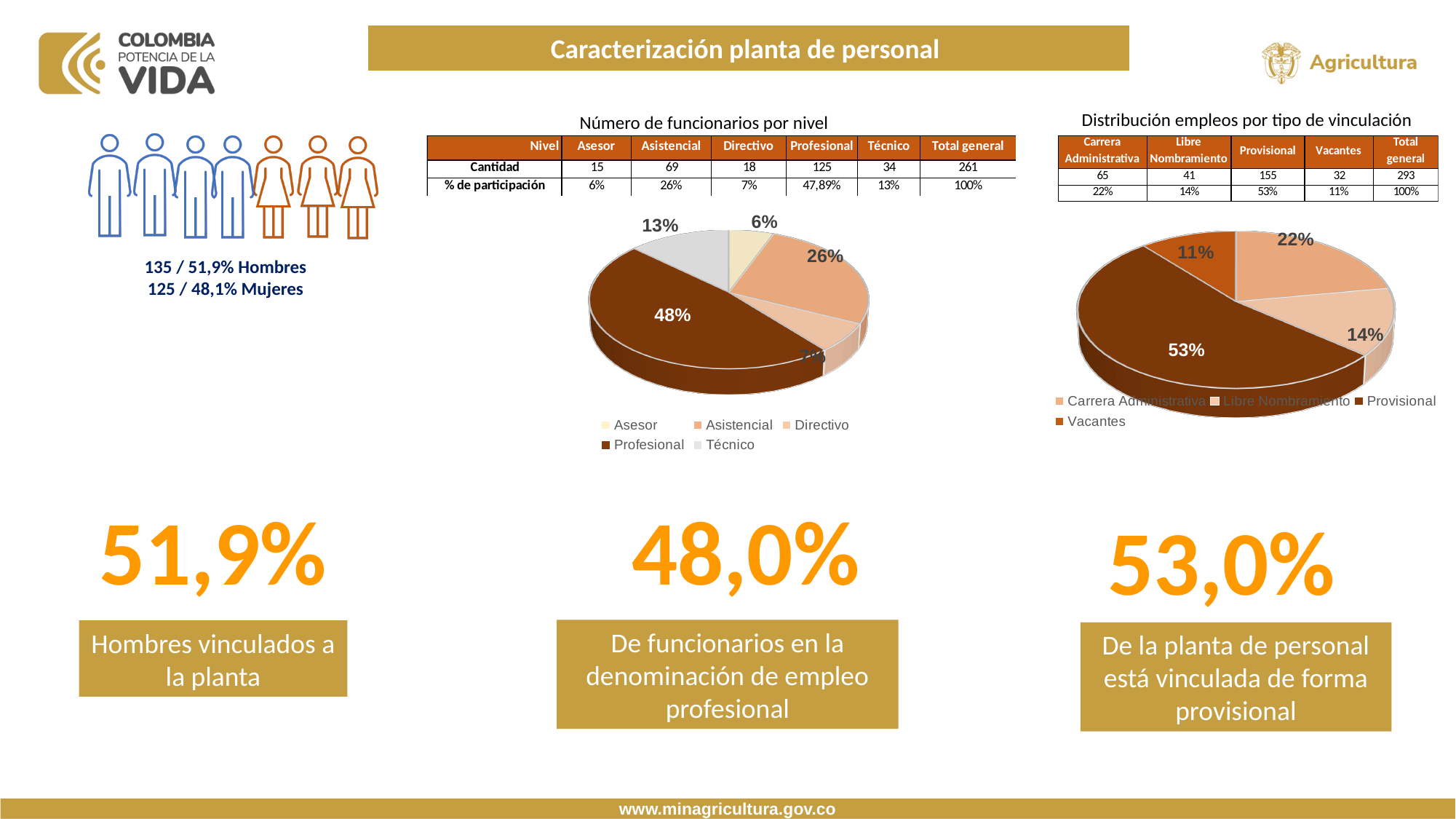
How many series does the legend of the "Número de funcionarios por nivel" pie chart list? 5 In the "Número de funcionarios por nivel" pie chart, what share does Profesional have? 48% In the "Distribución empleos por tipo de vinculación" pie chart, what share does Provisional have? 53% In the "Número de funcionarios por nivel" pie chart, what share does Asistencial have? 26% In the "Distribución empleos por tipo de vinculación" pie chart, which is larger, Libre Nombramiento or Carrera Administrativa? Carrera Administrativa In the "Número de funcionarios por nivel" pie chart, which category has the smallest slice? Asesor In the "Distribución empleos por tipo de vinculación" pie chart, which category has the smallest slice? Vacantes How many categories does the legend of the "Distribución empleos por tipo de vinculación" pie chart list? 4 In the "Número de funcionarios por nivel" pie chart, which category has the largest slice? Profesional In the "Número de funcionarios por nivel" pie chart, what is the difference between the Técnico and Asesor shares? 7% What type of chart is used under "Número de funcionarios por nivel"? pie chart